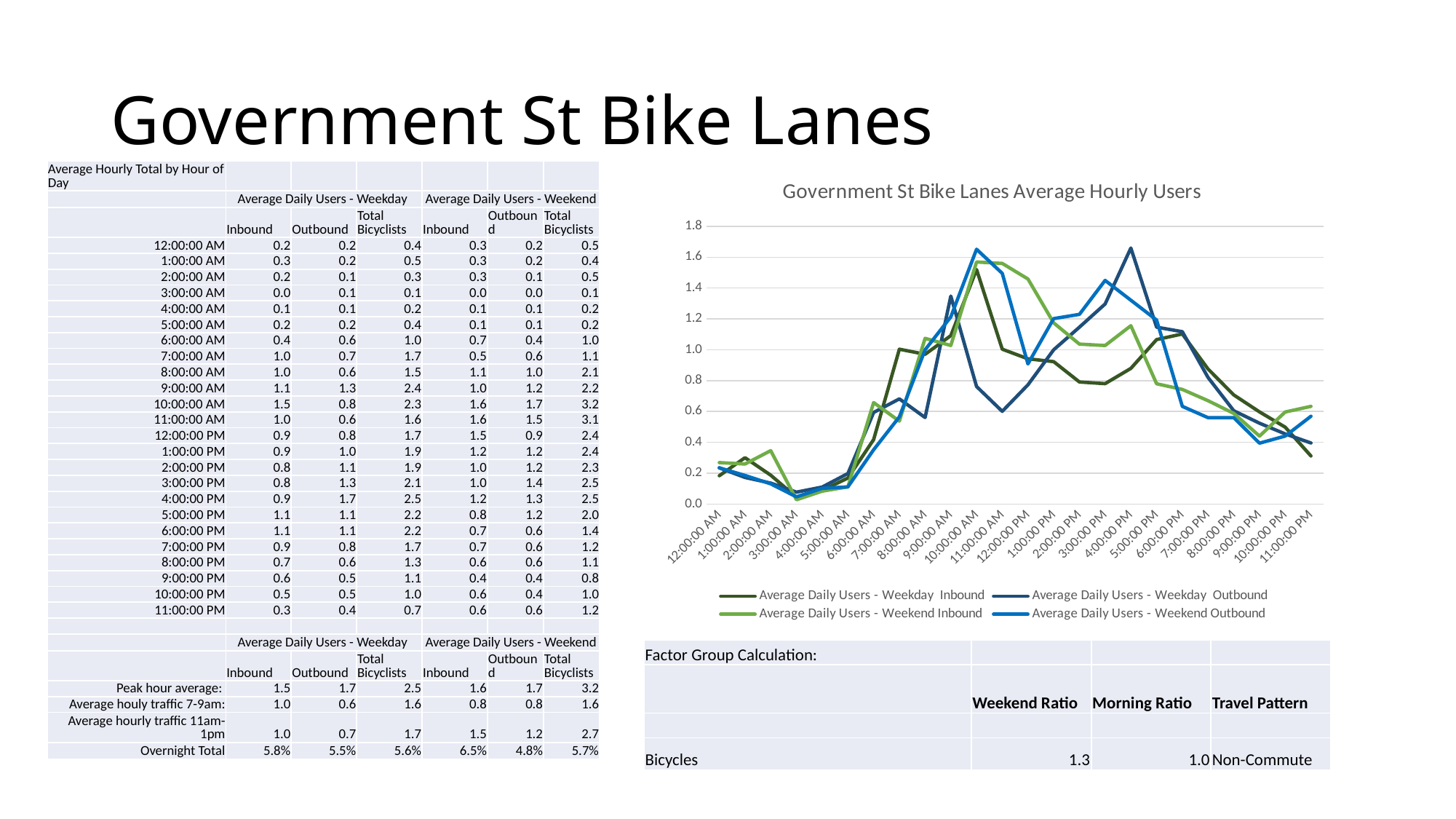
Does the Average Daily Users - Weekday Outbound series rise or fall from 4:00:00 PM to 11:00:00 PM? fall What is the title of the chart? Government St Bike Lanes Average Hourly Users Is the Average Daily Users - Weekday Inbound value at 3:00:00 AM greater or less than 0.2? less At 7:00:00 AM, which is larger: Average Daily Users - Weekday Inbound or Average Daily Users - Weekend Inbound? Average Daily Users - Weekday Inbound Is the Average Daily Users - Weekend Outbound value at 10:00:00 AM greater or less than 1.4? greater What kind of chart is shown on the slide? line chart At which hour does the Average Daily Users - Weekday Inbound series reach its highest value? 10:00:00 AM Does the Average Daily Users - Weekend Outbound series rise or fall from 3:00:00 AM to 10:00:00 AM? rise How many series does the chart legend list? 4 At which hour does the Average Daily Users - Weekday Outbound series reach its highest value? 4:00:00 PM Is the Average Daily Users - Weekday Outbound value at 4:00:00 PM greater or less than 1.6? greater How many hourly points are plotted along the x axis of the chart? 24